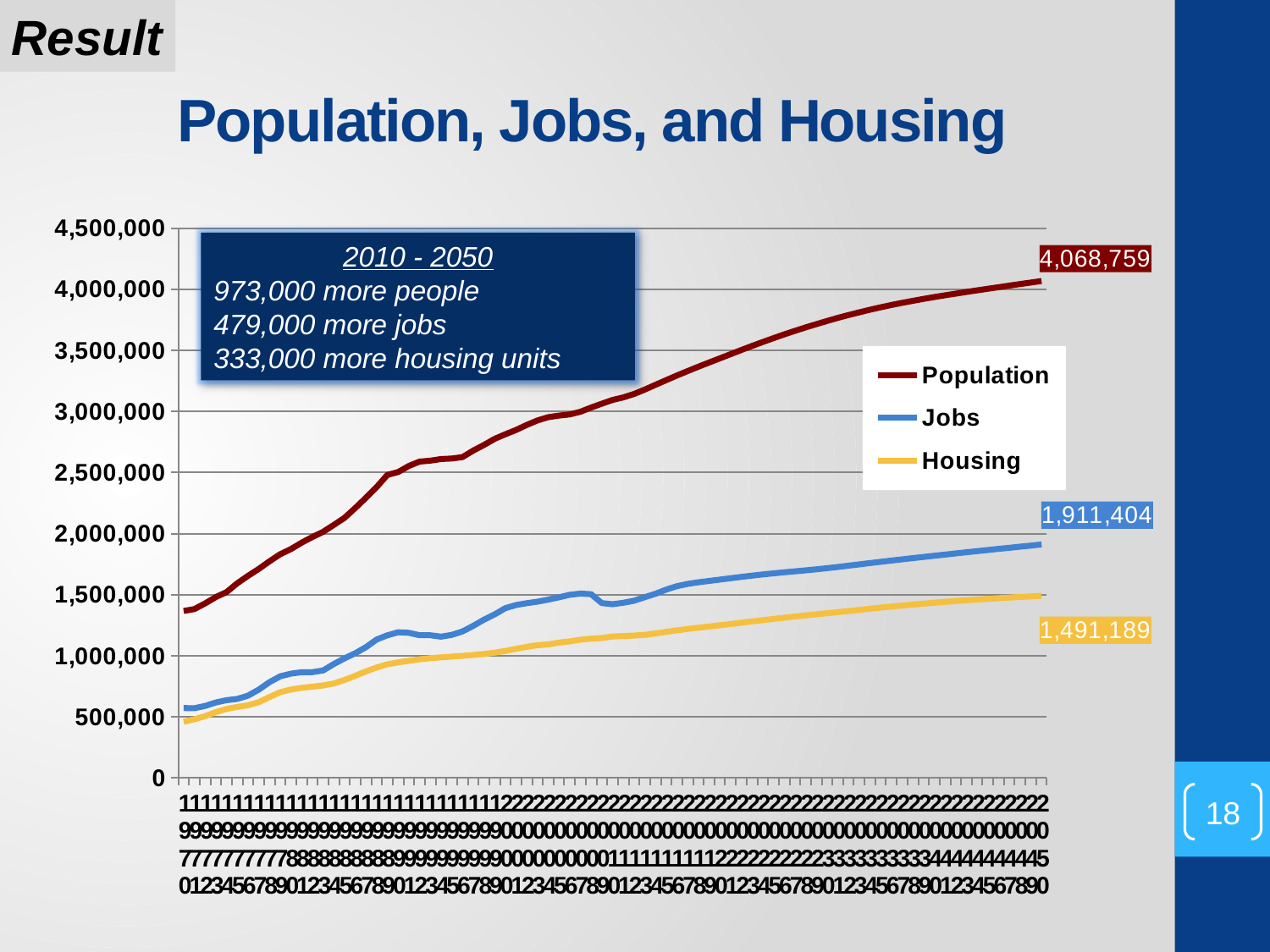
What is the final labeled value of the Population series? 4,068,759 What is the final labeled value of the Jobs series? 1,911,404 Which series has the highest final labeled value? Population What is the final labeled value of the Housing series? 1,491,189 Which series has the lowest final labeled value? Housing What kind of chart is shown on the slide? Line chart What is the title of the chart? Population, Jobs, and Housing Does the Population series rise or fall along the x axis? Rise What is the difference between the final labeled values of Population and Jobs? 2,157,355 Which is larger at the end of the chart, Jobs or Housing? Jobs How many series does the legend list? 3 What is the difference between the final labeled values of Jobs and Housing? 420,215